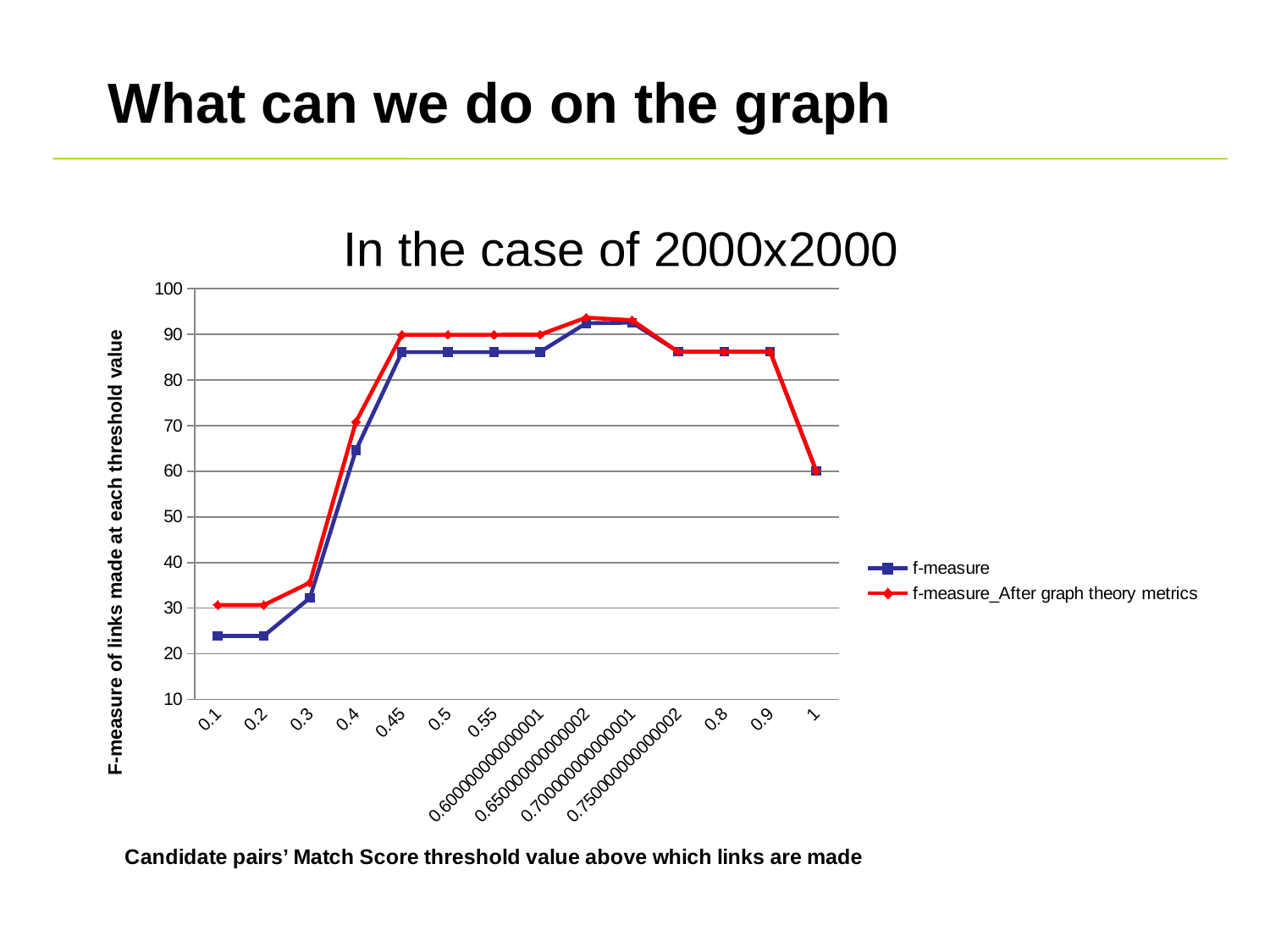
What is the title of the chart? In the case of 2000x2000 Which series is drawn in red? f-measure_After graph theory metrics Is the f-measure value at threshold 0.45 greater or less than 80? greater Do the f-measure values rise or fall as the threshold increases from 0.1 to 0.45? rise Is the f-measure value at threshold 0.1 greater or less than 30? less How many threshold values are plotted along the x axis? 14 At threshold 0.4, which series has the higher value: f-measure or f-measure_After graph theory metrics? f-measure_After graph theory metrics What kind of chart is shown on the slide? line chart Is the f-measure_After graph theory metrics value at threshold 0.4 greater or less than 60? greater How many series does the legend list? 2 At which threshold value does the f-measure_After graph theory metrics series reach its highest point? 0.650000000000002